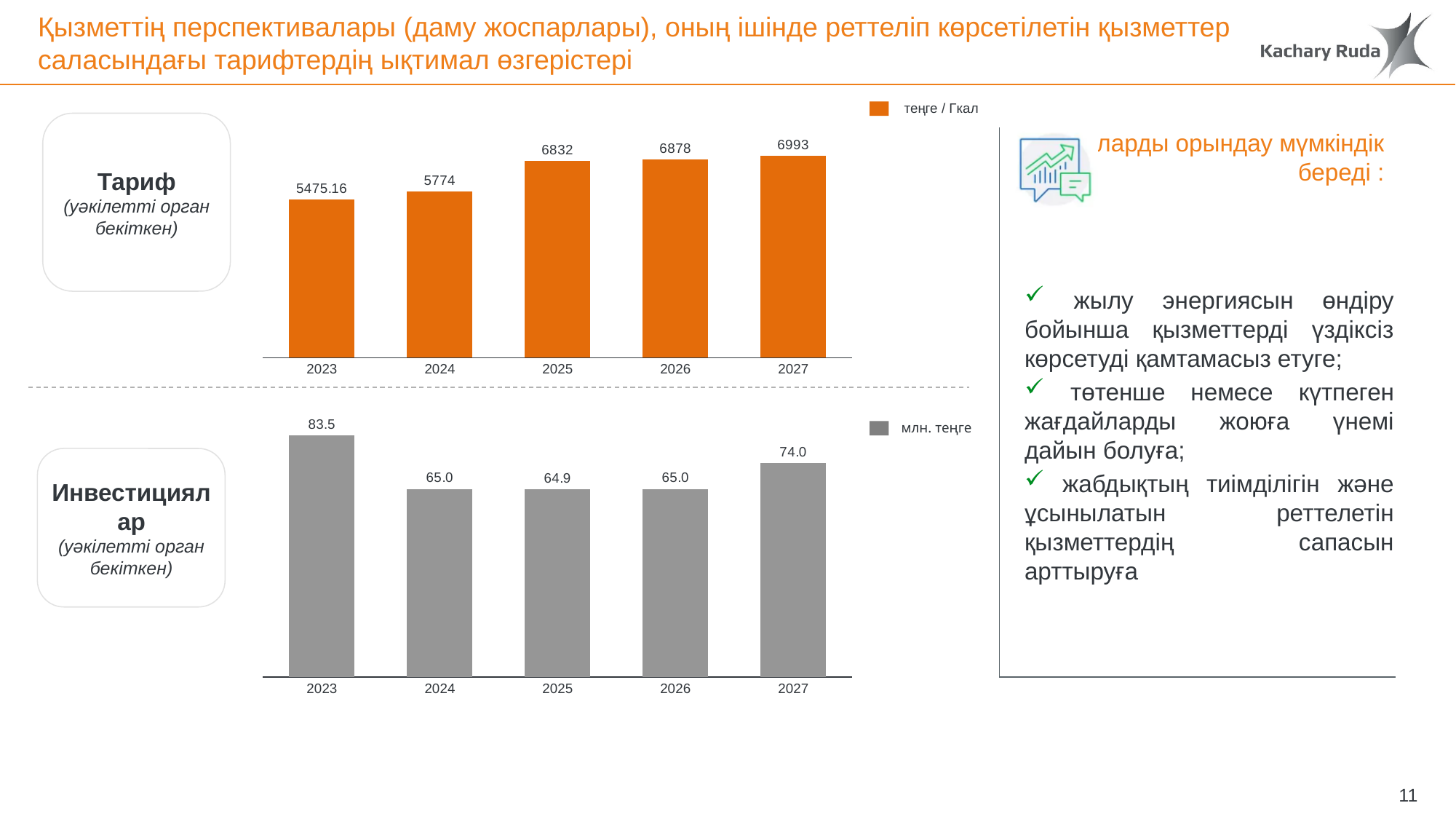
In the top chart (Тариф), do the values rise or fall from 2023 to 2027? rise In the bottom chart (Инвестициялар), what is the value for 2023? 83.5 What unit does the legend of the top chart (Тариф) show? теңге / Гкал In the top chart (Тариф), which year has the lowest value? 2023 In the top chart (Тариф), what is the difference between the values for 2025 and 2024? 1058 In the bottom chart (Инвестициялар), how many years are shown on the x axis? 5 In the top chart (Тариф), what is the value for 2027? 6993 In the top chart (Тариф), what is the value for 2023? 5475.16 In the bottom chart (Инвестициялар), what is the value for 2027? 74.0 In the bottom chart (Инвестициялар), what is the difference between the values for 2023 and 2027? 9.5 In the top chart (Тариф), which year has the highest value? 2027 In the bottom chart (Инвестициялар), which year has the highest value? 2023